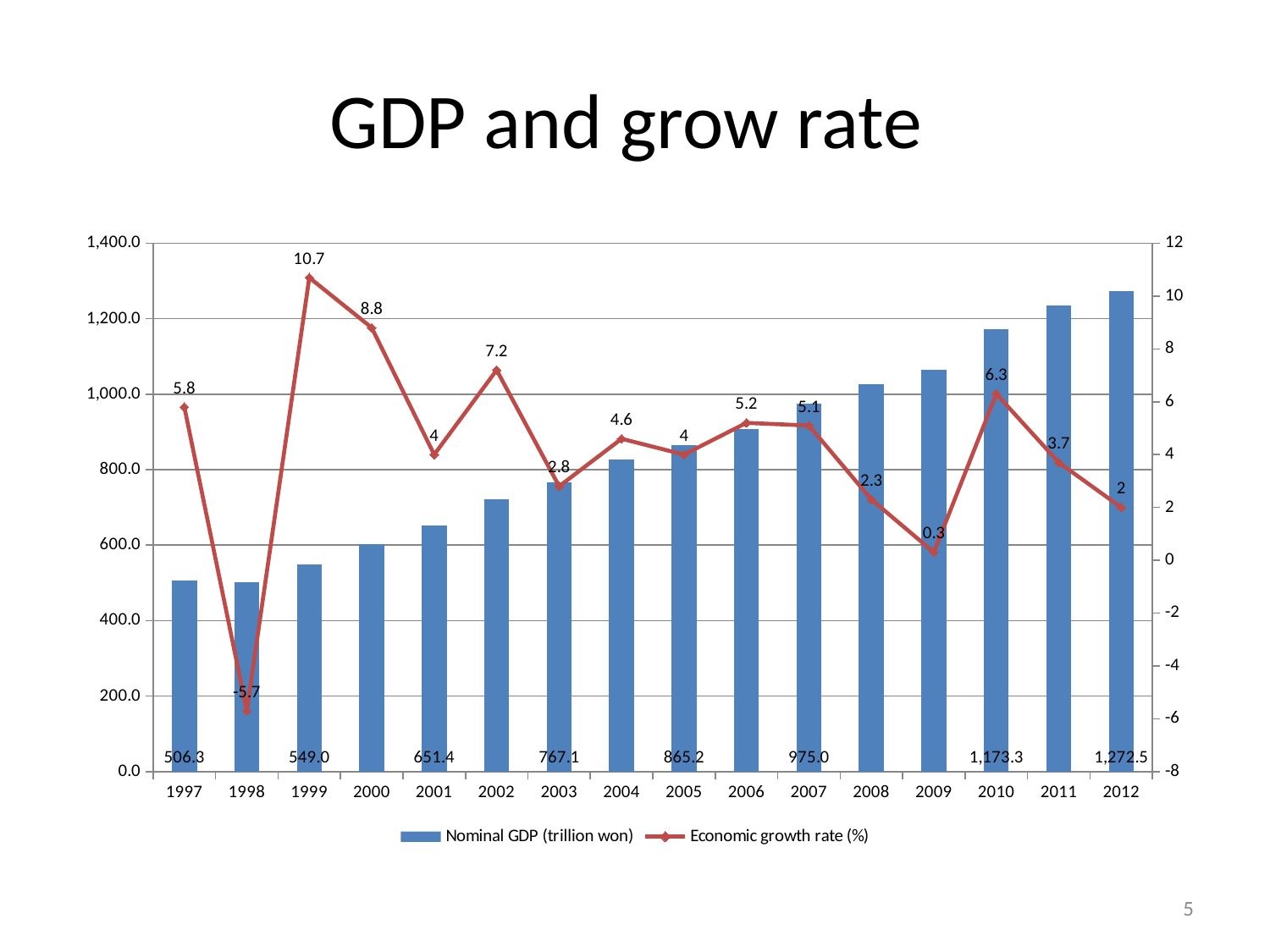
How many years are shown on the x axis? 16 Is the Nominal GDP value for 2008 greater or less than 1,000.0? greater How many series does the legend list? 2 What kind of chart is this? Combination bar and line chart What is the Economic growth rate (%) for 1998? -5.7 What is the Nominal GDP (trillion won) for 2010? 1,173.3 What is the Economic growth rate (%) for 1999? 10.7 Which year has the lowest Economic growth rate? 1998 What is the Nominal GDP (trillion won) for 2007? 975.0 Which year has the highest Economic growth rate? 1999 Which year had a higher Economic growth rate, 2000 or 2002? 2000 By how much did Nominal GDP (trillion won) in 2012 exceed that in 1997? 766.2